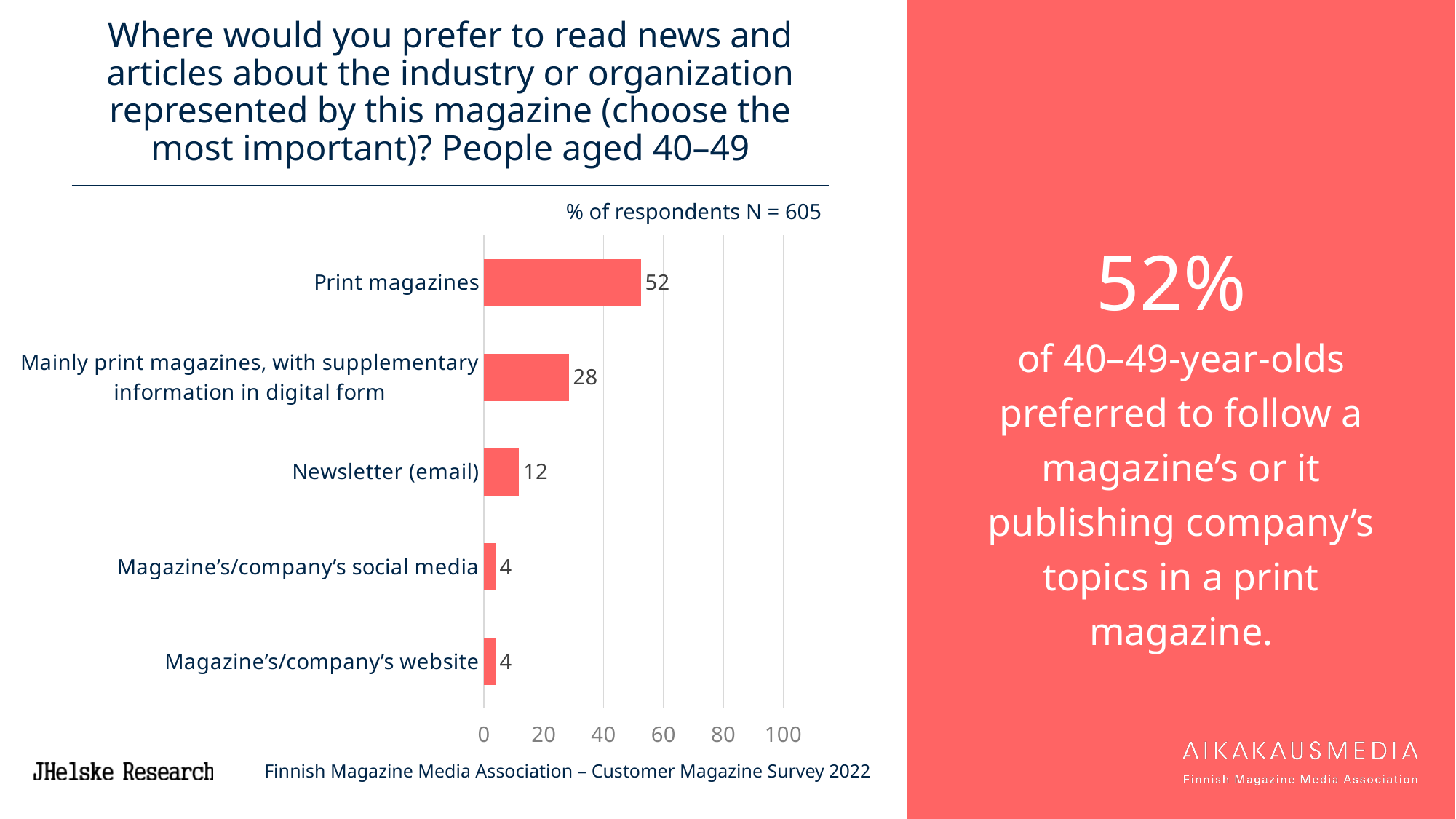
What is the number of respondents (N) stated above the chart? 605 What is the difference between the values for Print magazines and Newsletter (email)? 40 Which category has the highest value? Print magazines What is the difference between Print magazines and Mainly print magazines, with supplementary information in digital form? 24 What is the value for Mainly print magazines, with supplementary information in digital form? 28 How many categories are shown in the chart? 5 What percentage of respondents chose Print magazines? 52 Is the value for Print magazines greater or less than 40? greater What is the value for Magazine's/company's website? 4 What kind of chart is shown on the slide? Bar chart What is the value for Newsletter (email)? 12 Which is larger: the value for Newsletter (email) or for Magazine's/company's social media? Newsletter (email)